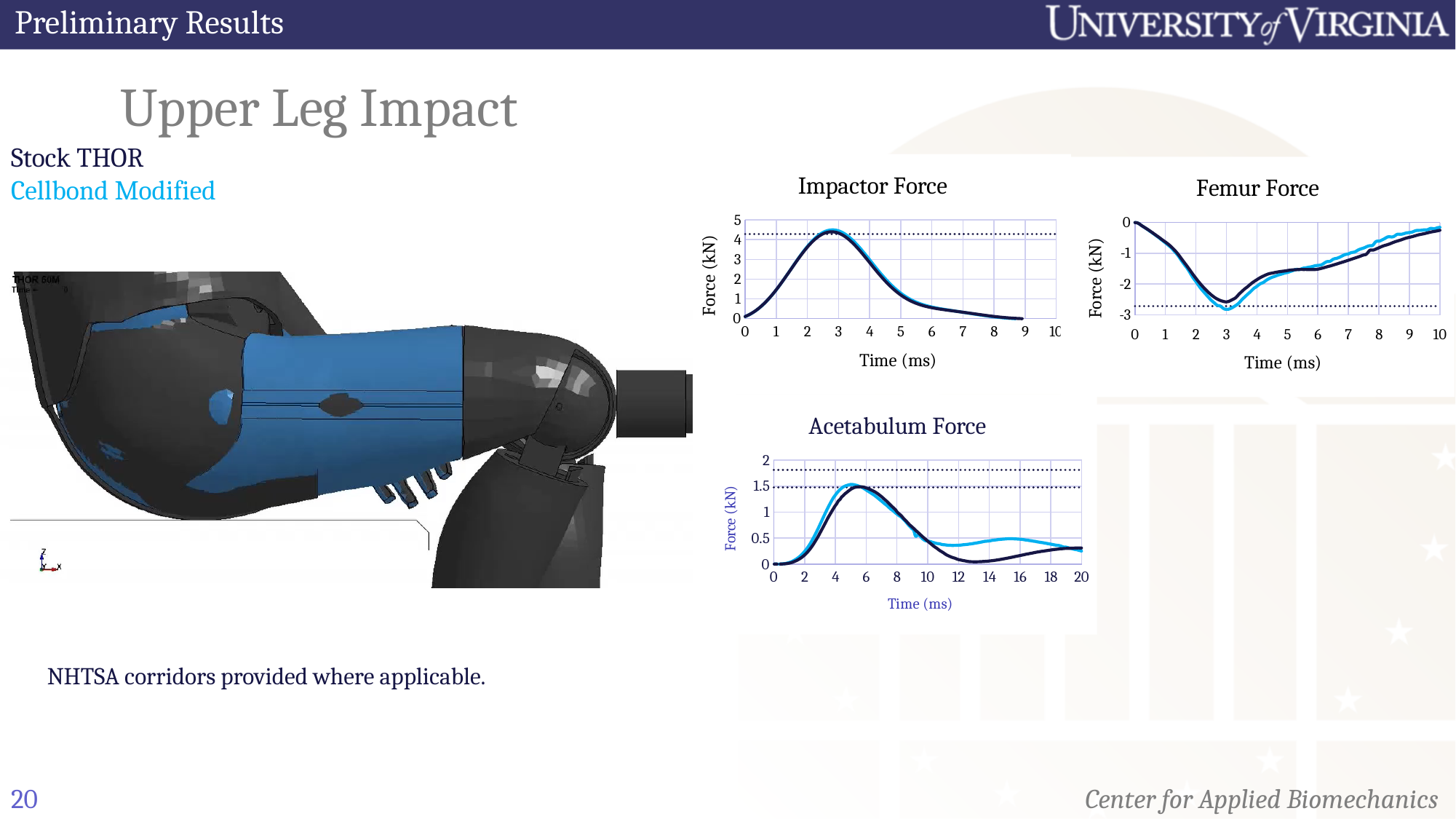
How many series are plotted in the Femur Force chart? 2 In the Femur Force chart, does the force rise or fall between 3 and 10 ms? rise In the Femur Force chart, is the minimum force greater or less than -2 kN? less In the Impactor Force chart, is the peak force greater or less than 5 kN? less In the Impactor Force chart, is the peak force greater or less than 4 kN? greater What is the x-axis label of the Acetabulum Force chart? Time (ms) How many charts are shown on the slide? 3 Which colour represents the Cellbond Modified series in the charts? light blue In the Impactor Force chart, does the force rise or fall between 0 and 3 ms? rise What kind of chart is the Impactor Force chart? line chart